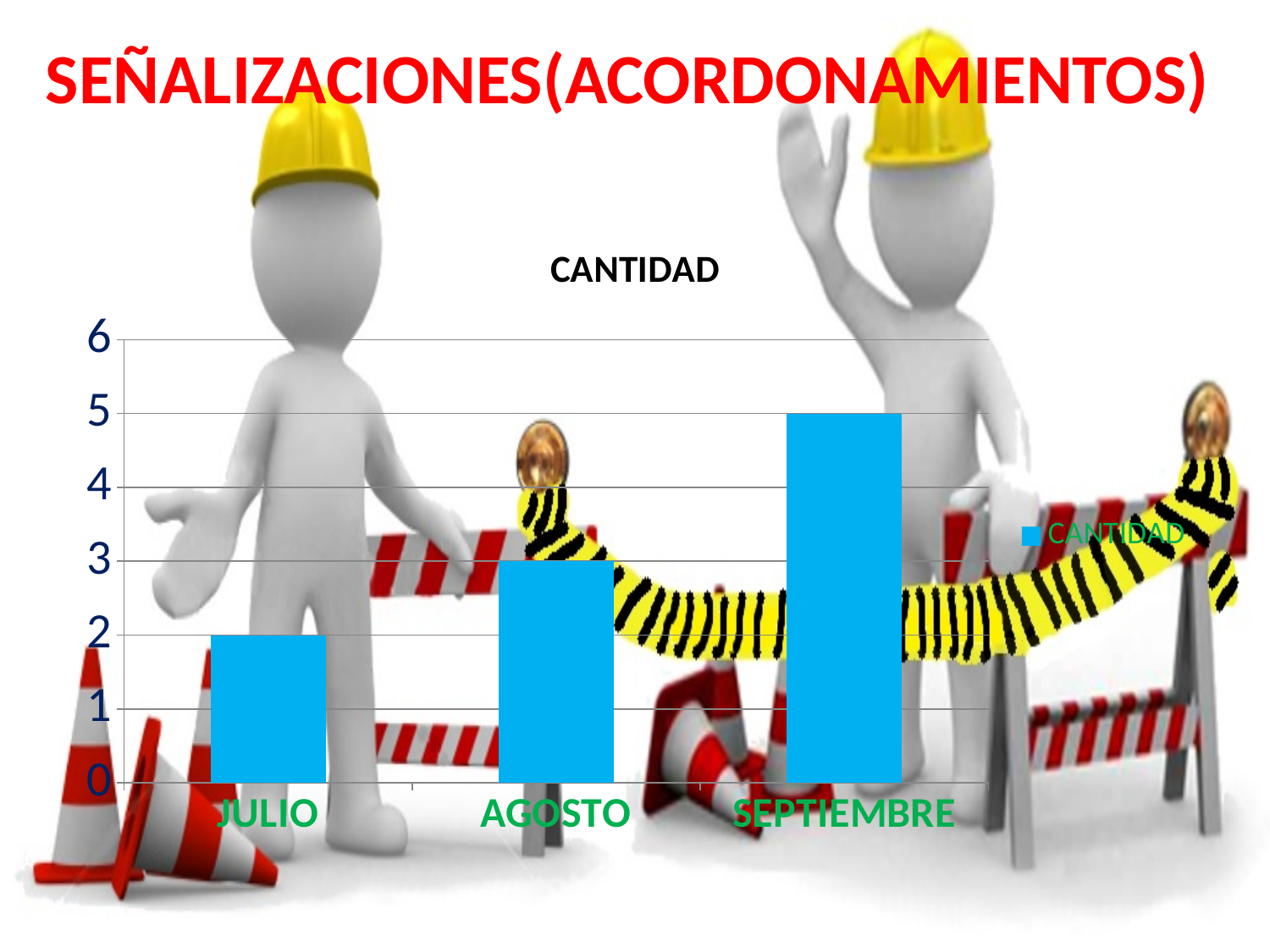
Which is larger, the value for AGOSTO or the value for JULIO? AGOSTO What kind of chart is shown? bar chart How many series does the legend list? 1 Which month has the highest value? SEPTIEMBRE What is the value for JULIO? 2 How many months are shown on the x axis? 3 Do the values rise or fall from JULIO to SEPTIEMBRE? rise What is the value for AGOSTO? 3 Is the value for SEPTIEMBRE greater or less than 4? greater Which month has the lowest value? JULIO What is the difference between the values for SEPTIEMBRE and JULIO? 3 What is the value for SEPTIEMBRE? 5